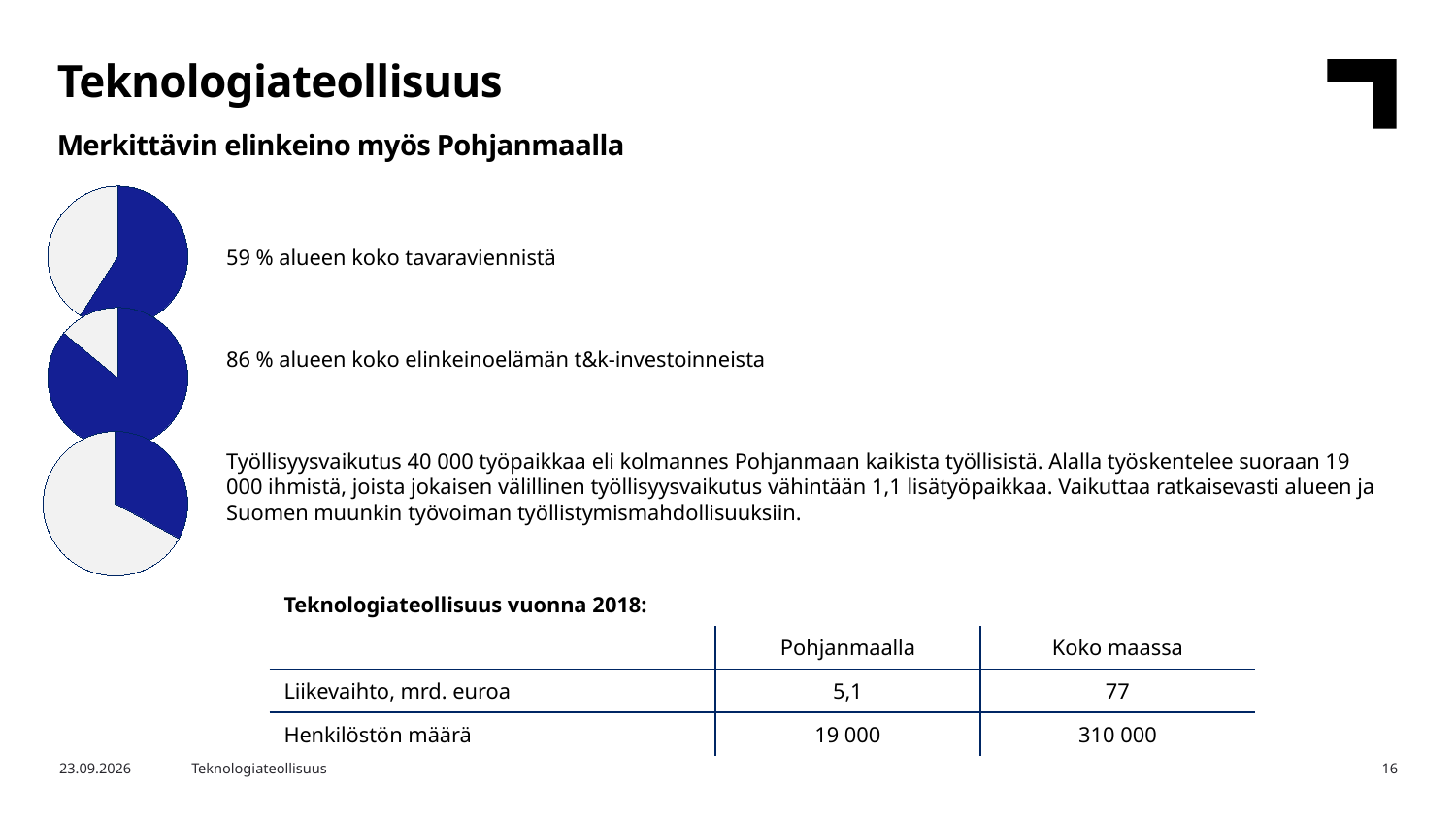
What is the title of the slide that contains the pie charts? Teknologiateollisuus How many pie charts are on the slide? 3 Is the blue slice of the top pie chart larger or smaller than the blue slice of the bottom pie chart? Larger What kind of charts are shown on the left side of the slide? Pie charts Which pie chart (top, middle or bottom) has the smallest blue slice? Bottom Is the blue slice of the bottom pie chart greater or less than 50% of the pie? less According to the text next to the top pie chart, what share of the region's total goods exports does the blue slice represent? 59 % According to the text next to the middle pie chart, what share of the region's business R&D investments does the blue slice represent? 86 % How many slices does each pie chart on the slide have? 2 Is the blue slice of the middle pie chart greater or less than 50% of the pie? greater What colour is used for the highlighted slice in the pie charts? Blue Which pie chart (top, middle or bottom) has the largest blue slice? Middle